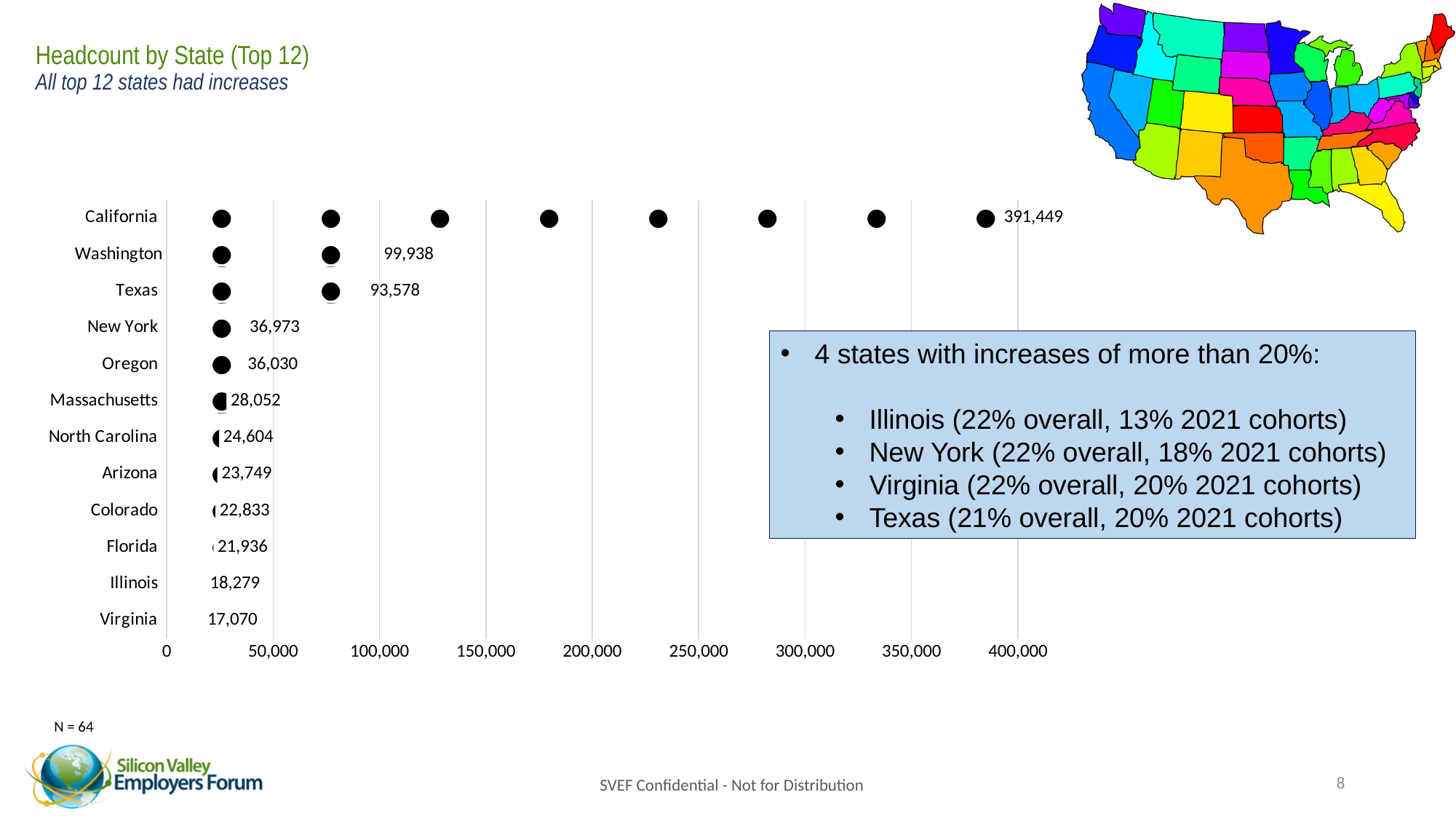
What is the difference in headcount between Illinois and Virginia? 1,209 How many states are shown in the chart? 12 Which has a larger headcount, Oregon or Colorado? Oregon What is the headcount for California? 391,449 What is the headcount for Texas? 93,578 What is the headcount for Virginia? 17,070 Which state has the highest headcount? California What is the title of the chart? Headcount by State (Top 12) Which state has the lowest headcount among the top 12? Virginia Is the headcount for Washington greater or less than 50,000? greater What is the headcount for Massachusetts? 28,052 What is the difference in headcount between Washington and Texas? 6,360